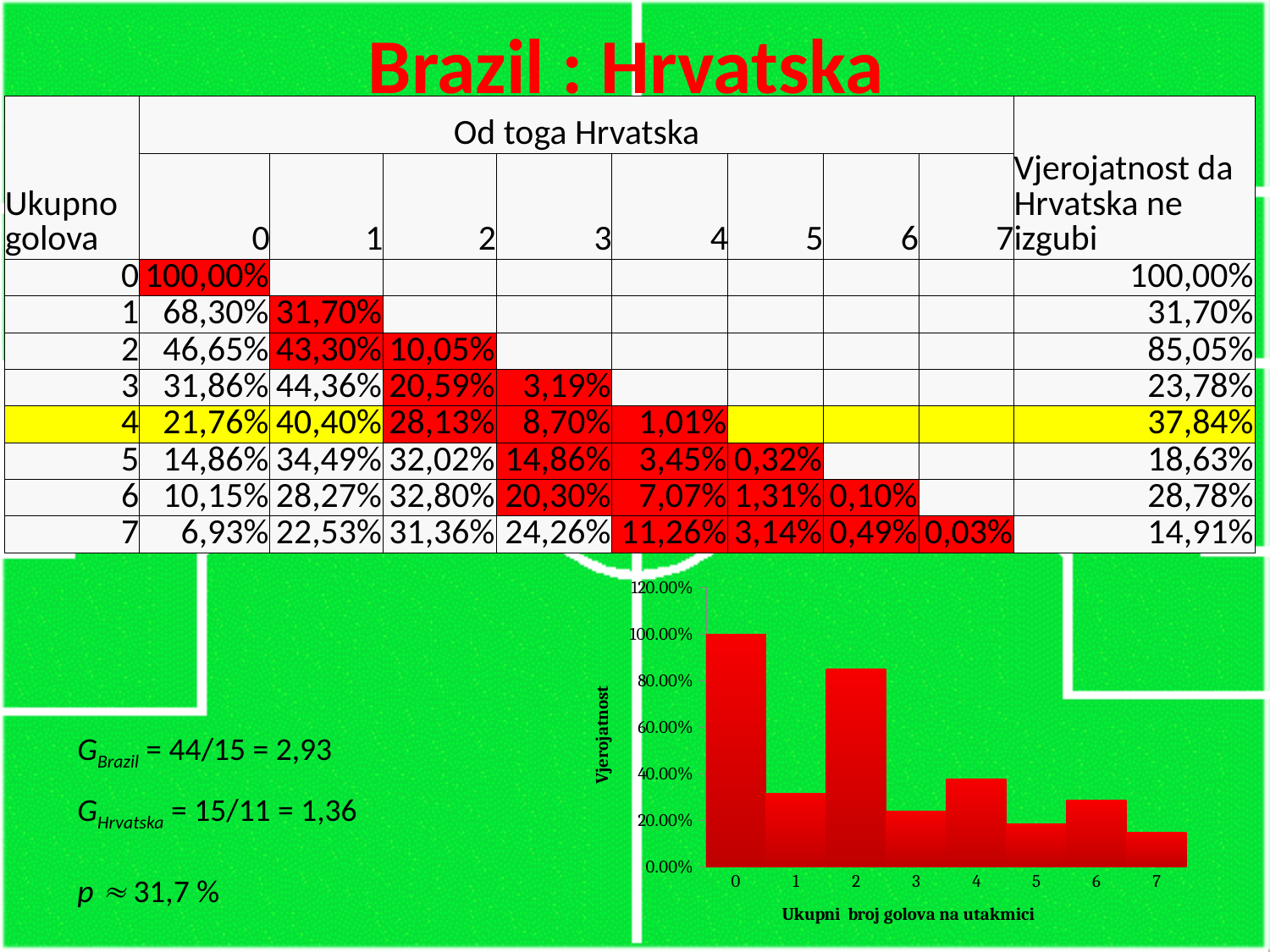
Is the value for category 1 in the chart greater or less than 40.00%? less What is the title of the x axis of the chart? Ukupni broj golova na utakmici What kind of chart is shown at the bottom of the slide? bar chart What is the title of the y axis of the chart? Vjerojatnost In the chart, which bar is taller: category 2 or category 4? 2 What is the value of the bar for category 0 in the chart? 100.00% Which category on the x axis has the highest bar in the chart? 0 Is the value for category 2 in the chart greater or less than 80.00%? greater Is the value for category 6 in the chart greater or less than 20.00%? greater Which category on the x axis has the lowest bar in the chart? 7 How many bars (categories) does the chart show along the x axis? 8